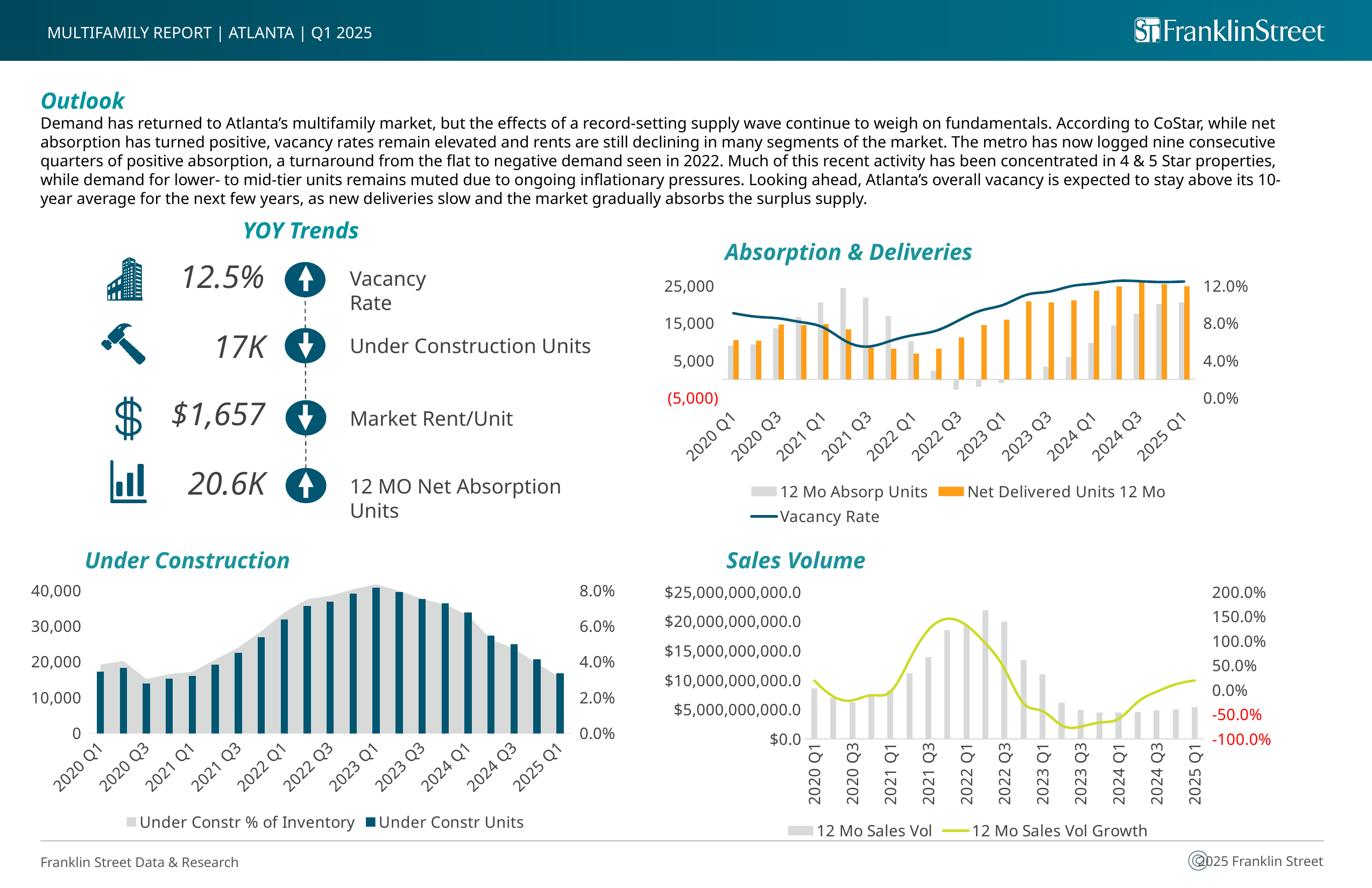
In the Under Construction chart, which quarter has the highest Under Constr Units bar? 2023 Q1 In the Under Construction chart, is the Under Constr Units value for 2025 Q1 greater or less than 20,000? less In the Absorption & Deliveries chart, what colour are the Net Delivered Units 12 Mo bars? Orange In the Absorption & Deliveries chart, which quarter has the highest 12 Mo Absorp Units bar? 2021 Q2 What kind of chart is the Sales Volume chart? Bar and line chart In the Absorption & Deliveries chart, is the Net Delivered Units 12 Mo value for 2025 Q1 greater or less than 15,000? greater In the Under Construction chart, how many series does the legend list? 2 In the Absorption & Deliveries chart, is the Vacancy Rate for 2025 Q1 greater or less than 8.0%? greater In the Absorption & Deliveries chart, how many series does the legend list? 3 In the Sales Volume chart, which quarter has the highest 12 Mo Sales Vol bar? 2022 Q2 In the Under Construction chart, which is larger, Under Constr Units in 2022 Q1 or in 2020 Q1? 2022 Q1